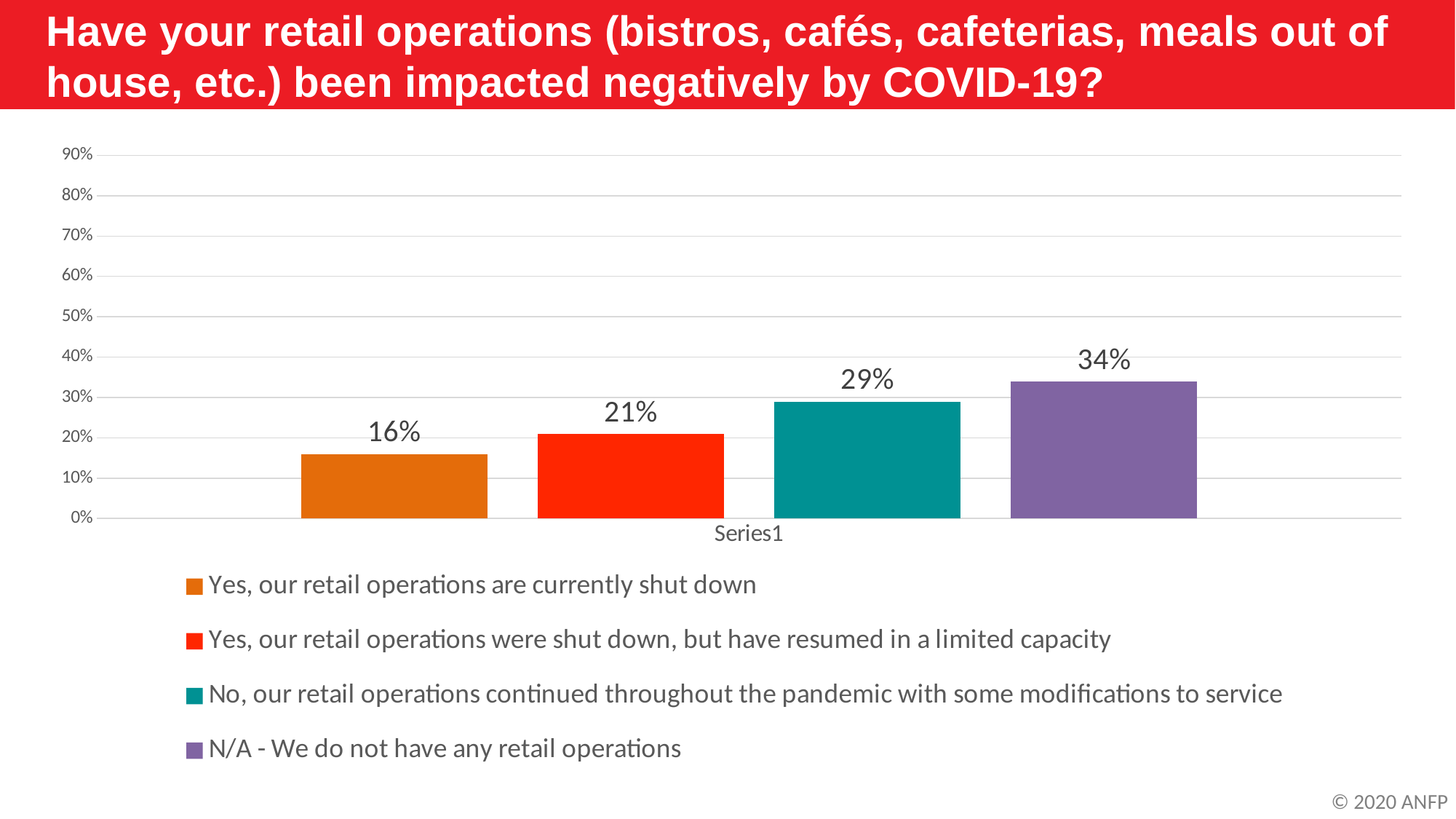
Do the bar values rise or fall from left to right? Rise What percentage of respondents said their retail operations continued throughout the pandemic with some modifications to service? 29% How many response options are plotted in the chart? 4 Which response option has the highest percentage? N/A - We do not have any retail operations What is the difference in percentage points between 'N/A - We do not have any retail operations' and 'Yes, our retail operations are currently shut down'? 18 percentage points What type of chart is shown on the slide? Bar chart What colour is the bar for 'No, our retail operations continued throughout the pandemic with some modifications to service'? Teal Which response option has the lowest percentage? Yes, our retail operations are currently shut down Which is larger: the percentage for operations that continued with modifications, or the percentage for operations that resumed in a limited capacity? Operations that continued with modifications (29%) What percentage of respondents said their retail operations were shut down but have resumed in a limited capacity? 21% What percentage of respondents said they do not have any retail operations (N/A)? 34% What percentage of respondents said their retail operations are currently shut down? 16%